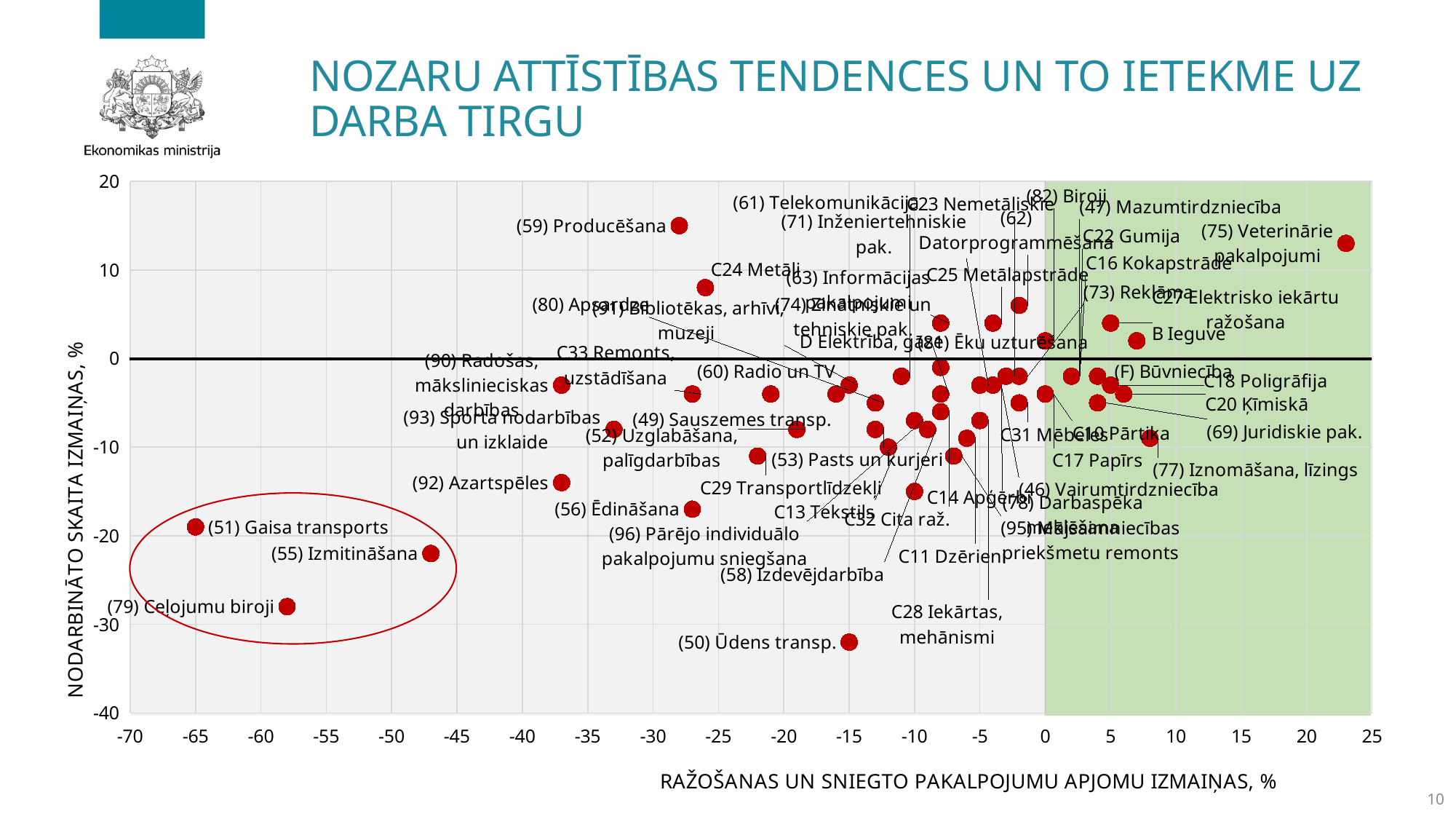
Which labelled point has the lowest value on the vertical axis (employment change)? (50) Ūdens transp. Is the horizontal-axis value for (51) Gaisa transports greater or less than -60? less What is the title of the vertical axis of the chart? NODARBINĀTO SKAITA IZMAIŅAS, % Is the vertical-axis value for (59) Producēšana greater or less than 10? greater Is the vertical-axis value for (50) Ūdens transp. greater or less than -30? less What kind of chart is shown on the slide? Scatter chart Which has the higher vertical-axis value, (92) Azartspēles or (56) Ēdināšana? (92) Azartspēles Which has the higher horizontal-axis value, (55) Izmitināšana or (79) Ceļojumu biroji? (55) Izmitināšana Which labelled point has the lowest value on the horizontal axis (output change)? (51) Gaisa transports Which labelled point has the highest value on the horizontal axis (output change)? (75) Veterinārie pakalpojumi What is the title of the horizontal axis of the chart? RAŽOŠANAS UN SNIEGTO PAKALPOJUMU APJOMU IZMAIŅAS, %